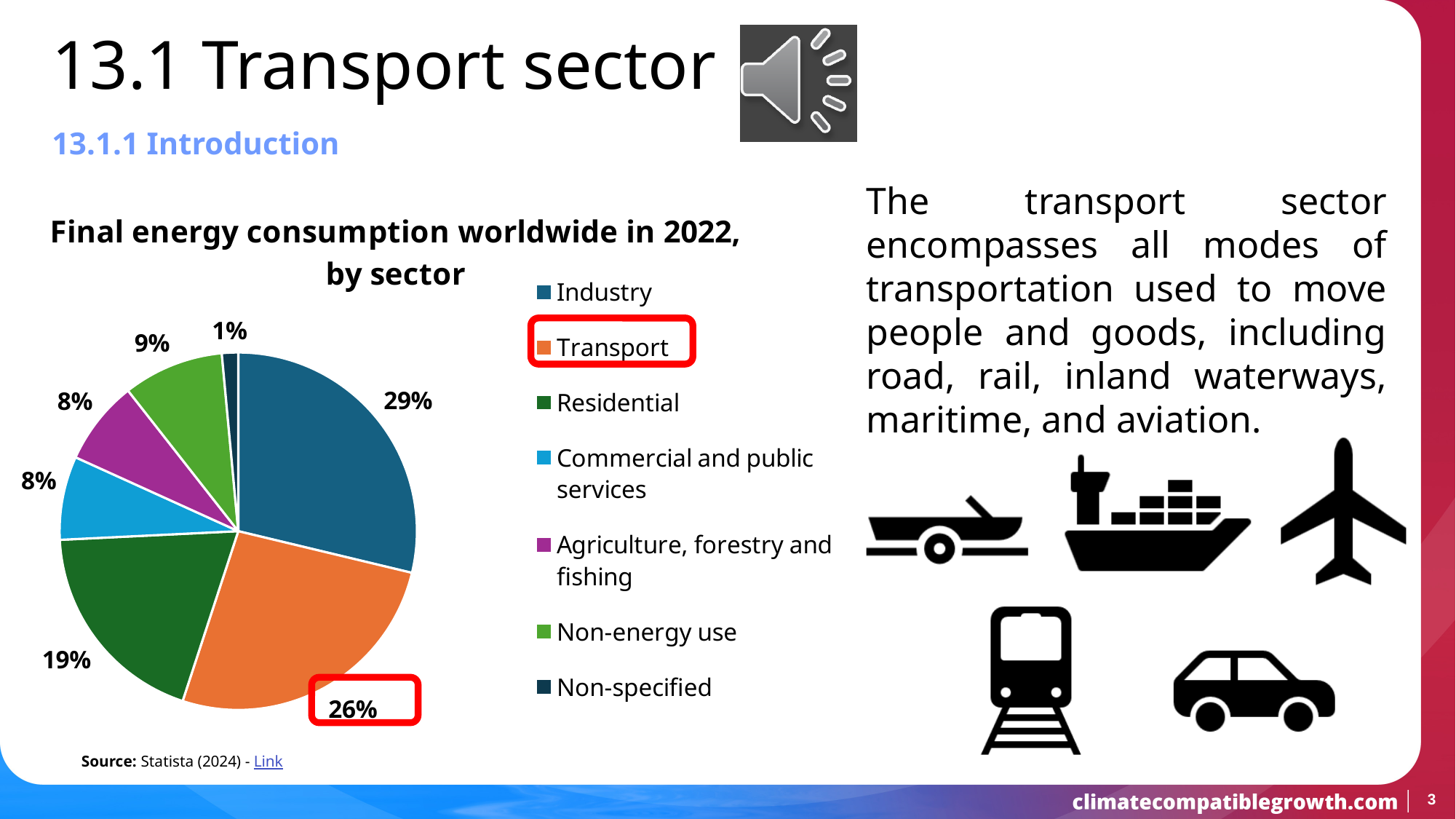
What percentage is shown for Non-energy use? 9% How many sectors does the legend list? 7 Which sector has the largest share of the pie chart? Industry What is the title of the pie chart? Final energy consumption worldwide in 2022, by sector Which is larger, the share for Transport or the share for Residential? Transport What share of final energy consumption worldwide in 2022 does the Transport sector account for? 26% What percentage is shown for Residential? 19% What is the value shown for Industry in the pie chart? 29% What kind of chart is shown on the slide? Pie chart What is the difference in percentage points between Industry and Transport? 3 Which legend entry is highlighted with a red box? Transport Which sector has the smallest share of the pie chart? Non-specified